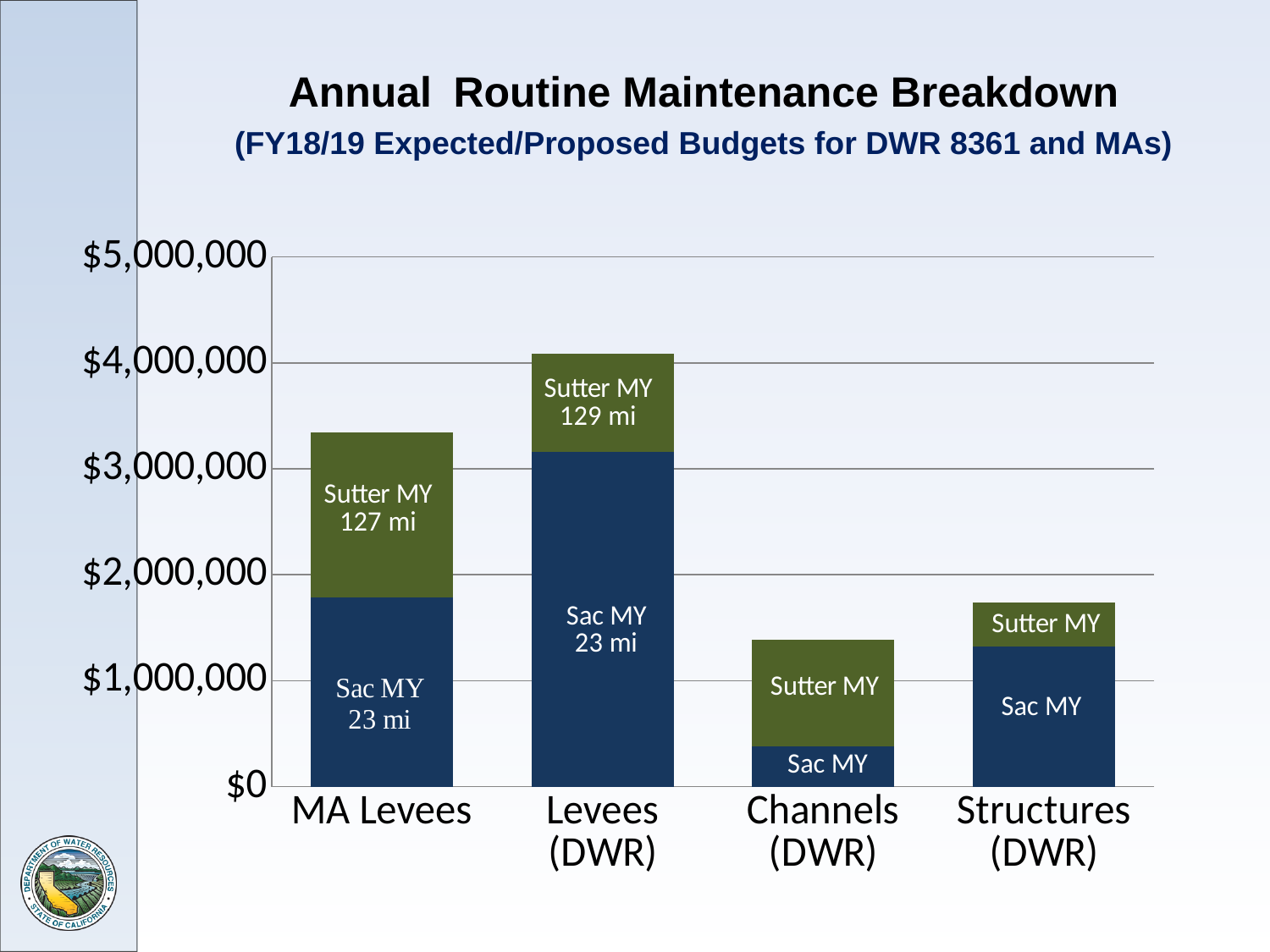
Is the total value for Structures (DWR) greater or less than $2,000,000? less How many series are stacked in each bar? 2 Which category has the highest total bar? Levees (DWR) How many categories are shown along the x axis? 4 Which has the larger total bar, Structures (DWR) or Channels (DWR)? Structures (DWR) Is the total value for MA Levees greater or less than $3,000,000? greater Which category has the lowest total bar? Channels (DWR) Is the total value for Channels (DWR) greater or less than $1,000,000? greater How many miles are labelled for the Sutter MY segment of the MA Levees bar? 127 mi What kind of chart is shown on the slide? Stacked bar chart What is the title of the chart? Annual Routine Maintenance Breakdown